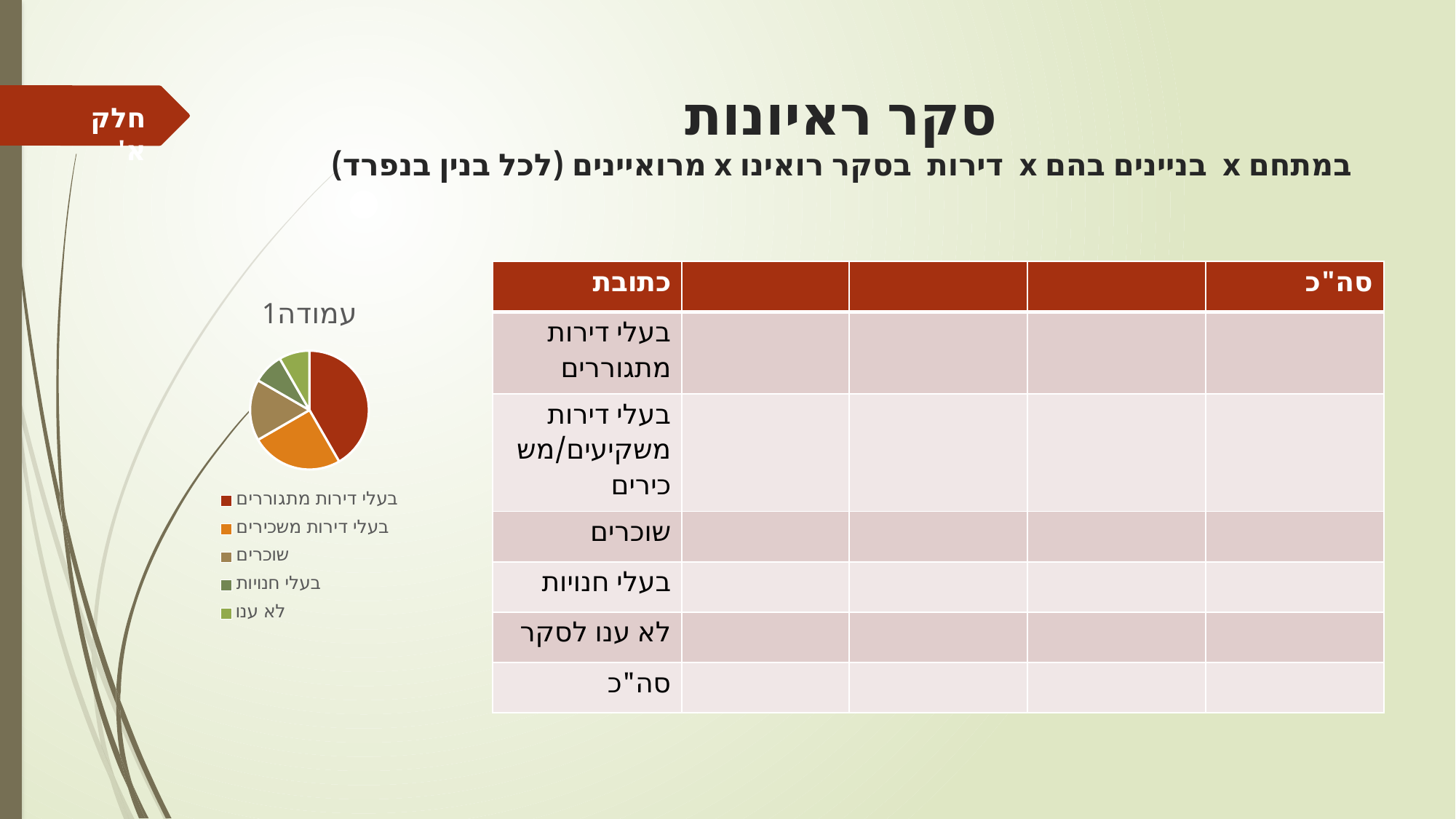
Which slice is larger in the pie chart: שוכרים or בעלי חנויות? שוכרים How many slices does the pie chart have? 5 Which category has the largest slice in the pie chart? בעלי דירות מתגוררים What is the title of the pie chart? עמודה1 How many entries does the pie chart's legend list? 5 What kind of chart is shown on the slide? pie chart Which slice is larger in the pie chart: בעלי דירות מתגוררים or בעלי דירות משכירים? בעלי דירות מתגוררים Which slice is larger in the pie chart: בעלי דירות משכירים or שוכרים? בעלי דירות משכירים What colour is the slice for בעלי דירות משכירים in the pie chart? orange